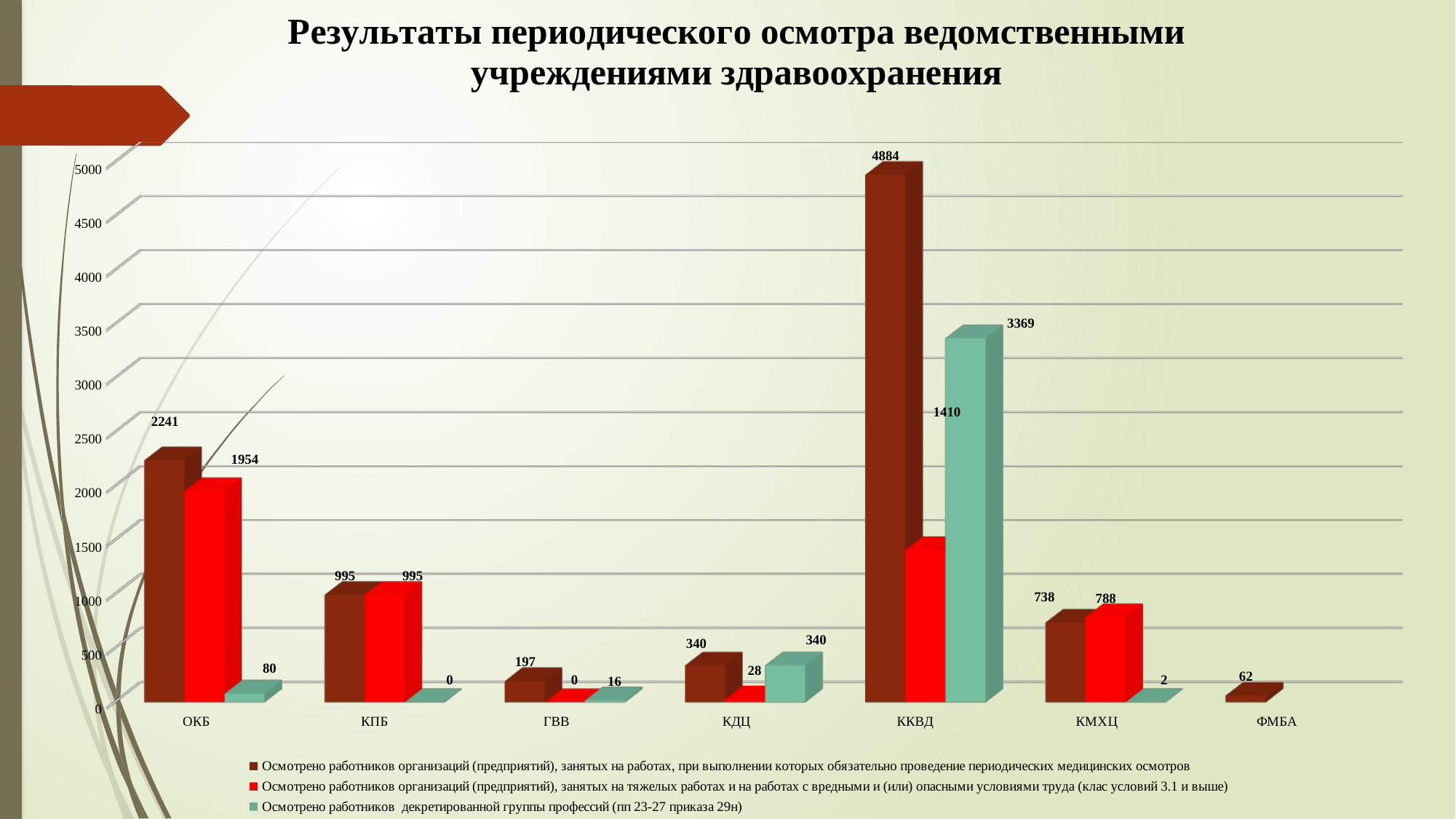
What is the title of the chart? Результаты периодического осмотра ведомственными учреждениями здравоохранения For КМХЦ, which is larger: the dark brown bar or the red bar? the red bar (788) What type of chart is shown on the slide? bar chart How many series does the legend list? 3 What is the value of the teal bar (third series) for КДЦ? 340 What is the difference between the dark brown bar and the red bar for ККВД? 3474 What is the value of the teal bar (third series, декретированная группа профессий) for ККВД? 3369 Which category has the highest value for the dark brown bar (first series)? ККВД How many categories (institutions) are shown on the x axis? 7 What is the value of the dark brown bar (first series) for ККВД? 4884 Which category has the lowest value for the dark brown bar (first series)? ФМБА What is the value of the red bar (second series) for ОКБ? 1954